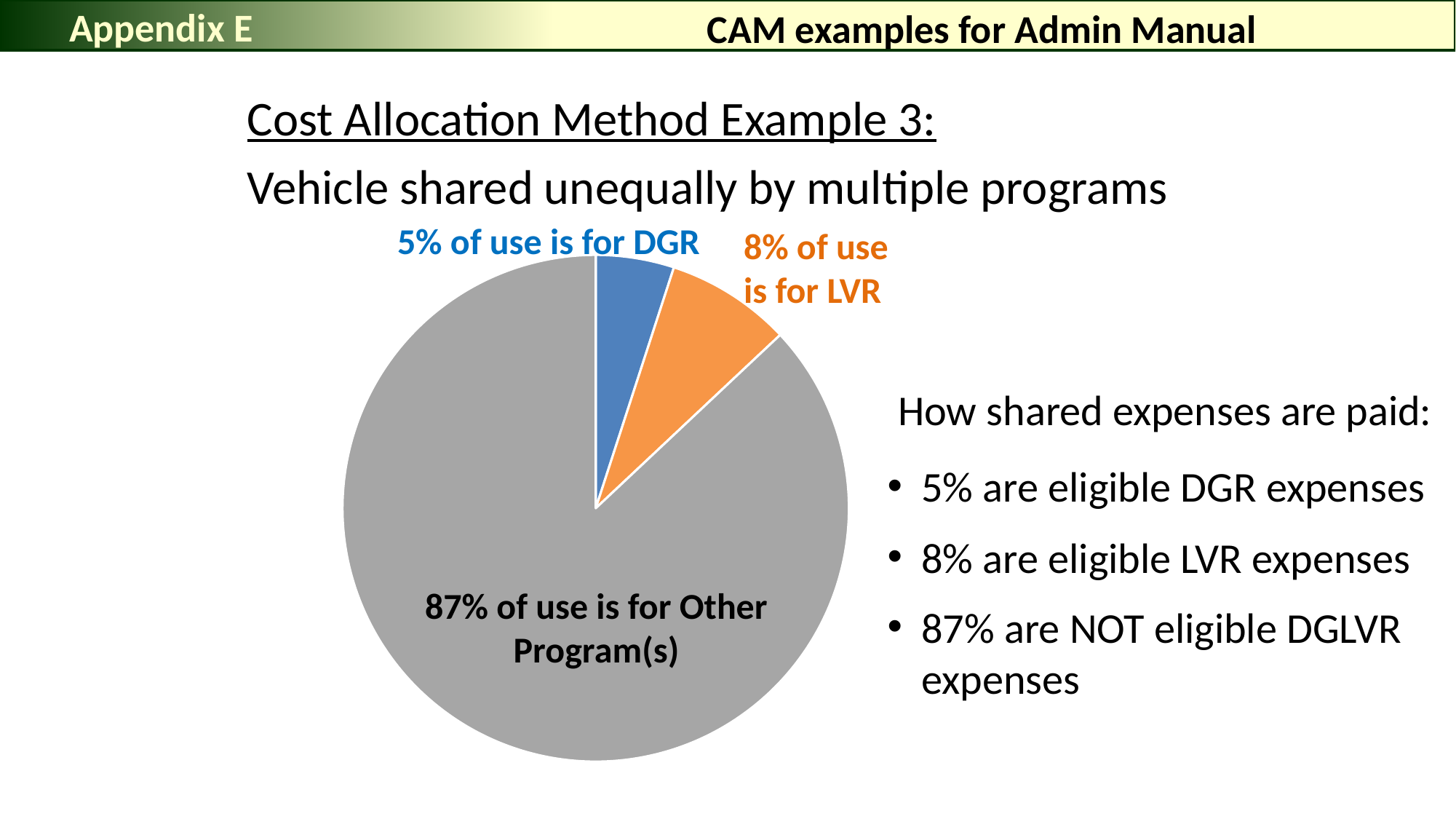
What is the difference between the share of use for LVR and the share of use for DGR? 3% What share of vehicle use is for LVR according to the pie chart? 8% What colour is the slice representing LVR use in the pie chart? orange What is the difference between the share of use for Other Program(s) and the share of use for LVR? 79% What share of vehicle use is for Other Program(s) according to the pie chart? 87% Which slice of the pie chart is the largest? Other Program(s) Which slice of the pie chart is the smallest? DGR What kind of chart is shown on the slide? pie chart What colour is the slice representing DGR use in the pie chart? blue Which is larger in the pie chart, the share for DGR or the share for LVR? LVR What share of vehicle use is for DGR according to the pie chart? 5% How many slices does the pie chart have? 3